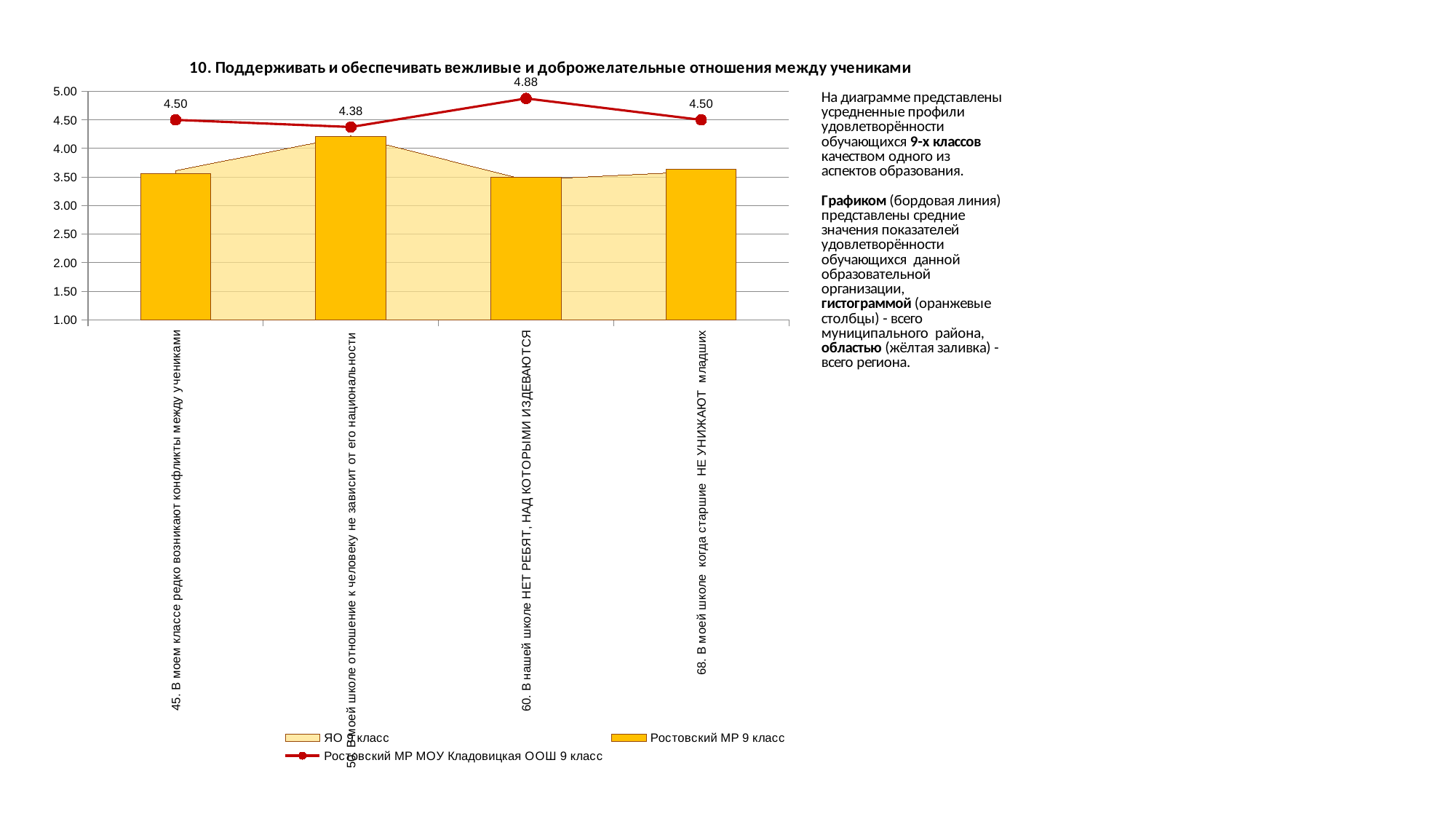
For which question does the red line have its lowest value? В моей школе отношение к человеку не зависит от его национальности What is the value of the red line for question 45 (В моем классе редко возникают конфликты между учениками)? 4.50 What is the value of the red line (Ростовский МР МОУ Кладовицкая ООШ 9 класс) for question 60 (В нашей школе НЕТ РЕБЯТ, НАД КОТОРЫМИ ИЗДЕВАЮТСЯ)? 4.88 Is the orange bar (Ростовский МР 9 класс) for the question 'В моей школе отношение к человеку не зависит от его национальности' greater or less than 4.00? greater What is the difference between the highest and lowest values of the red line? 0.50 Which is larger on the red line: the value for question 60 or the value for question 68? Question 60 (4.88) Is the orange bar (Ростовский МР 9 класс) for question 60 greater or less than 4.00? less What is the value of the red line for the question 'В моей школе отношение к человеку не зависит от его национальности'? 4.38 For which question does the red line (Ростовский МР МОУ Кладовицкая ООШ 9 класс) reach its highest value? 60. В нашей школе НЕТ РЕБЯТ, НАД КОТОРЫМИ ИЗДЕВАЮТСЯ How many series does the legend list? 3 What kind of chart is shown on the slide? Combination of area chart (yellow fill), bar chart (orange bars) and line chart (red line) How many questions (categories) are shown on the x axis? 4